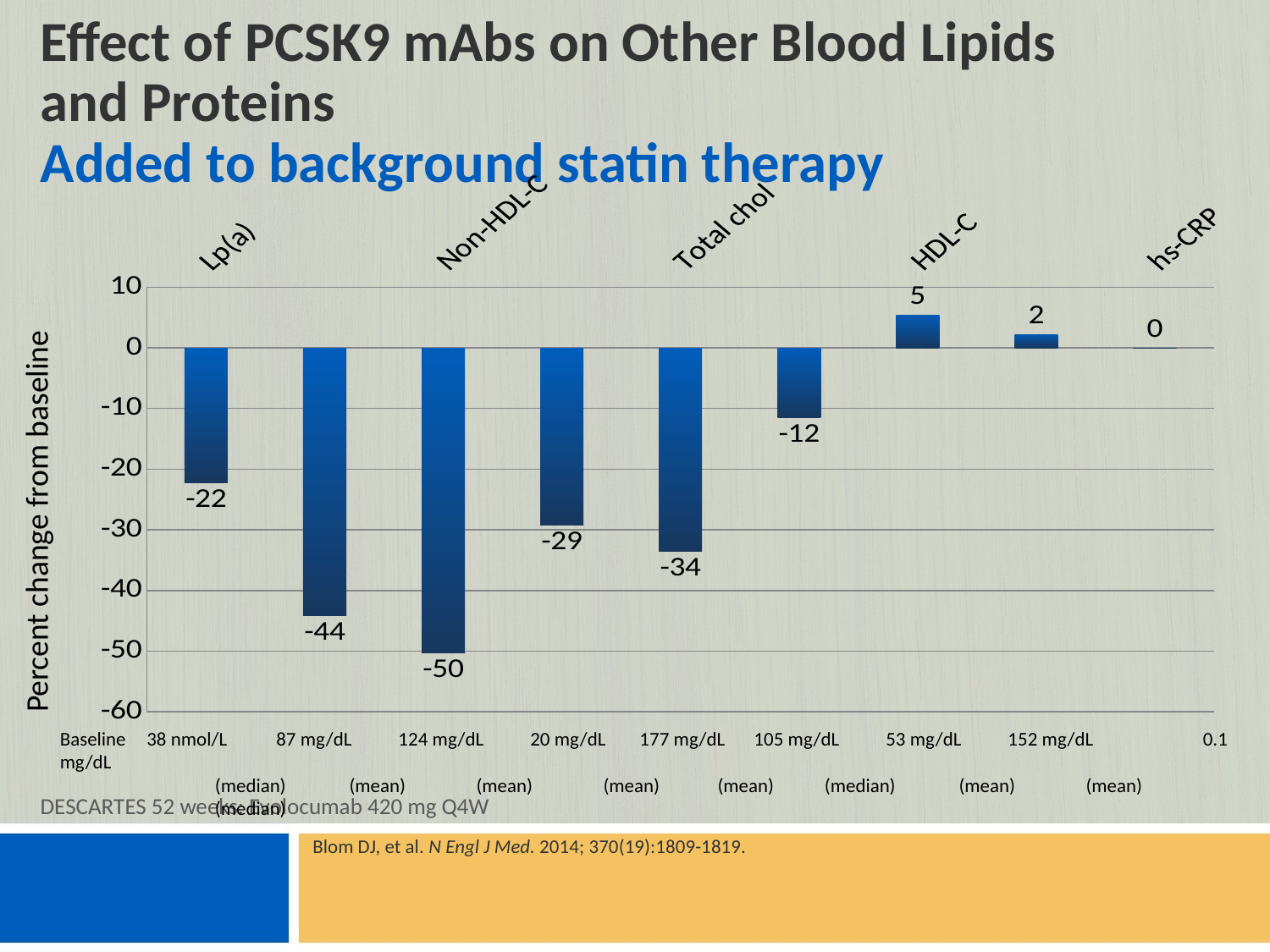
What is the percent change from baseline for hs-CRP? 0 What is the percent change from baseline for Non-HDL-C? -50 What is the difference between the percent change for Lp(a) and for Total chol? 12 How many bars are plotted in the chart? 9 What is the title of the vertical axis? Percent change from baseline What kind of chart is shown on the slide? bar chart What is the percent change from baseline for Lp(a)? -22 What is the percent change from baseline for HDL-C? 5 What is the percent change from baseline for Total chol? -34 Which has the larger percent change from baseline, HDL-C or hs-CRP? HDL-C Which labelled category shows the highest percent change from baseline? HDL-C Which labelled category shows the largest decrease from baseline? Non-HDL-C